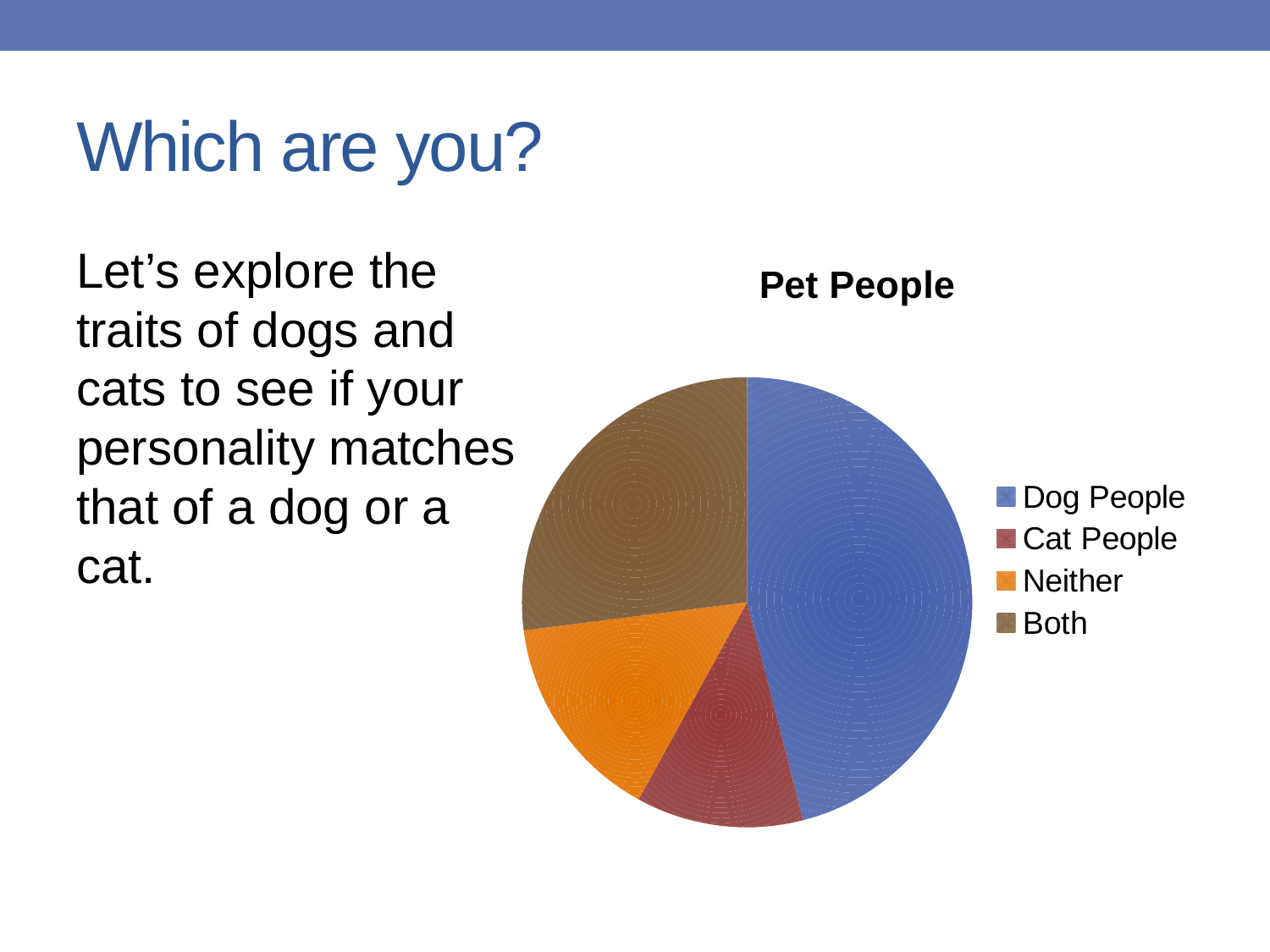
Which slice is larger, Both or Neither? Both How many categories does the pie chart have? 4 Which slice is larger, Neither or Cat People? Neither What colour is the Neither slice? orange What is the title of the chart? Pet People Which category has the smallest slice of the pie? Cat People How many entries does the legend list? 4 Which slice is larger, Dog People or Both? Dog People What kind of chart is shown on the slide? pie chart Which category has the largest slice of the pie? Dog People